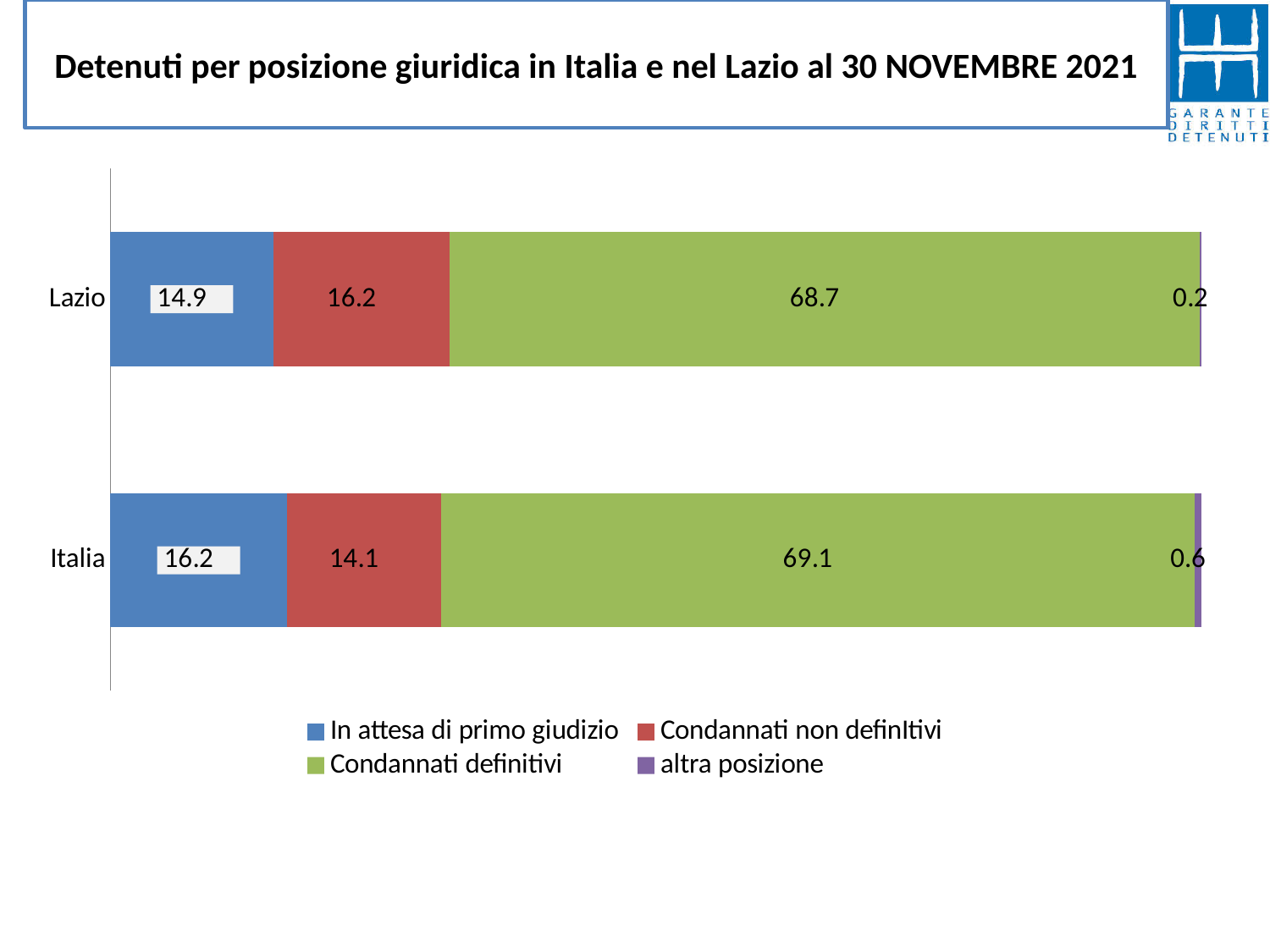
What is the total of the stacked bar for Lazio? 100.0 What is the value for "Condannati definitivi" for Lazio? 68.7 Which is larger: "Condannati non definitivi" for Lazio or for Italia? Lazio Which series has the smallest value for Lazio? altra posizione What is the value for "In attesa di primo giudizio" for Italia? 16.2 What kind of chart is shown on the slide? Stacked bar chart Which series has the largest value for Italia? Condannati definitivi What is the value for "Condannati non definitivi" for Lazio? 16.2 How many series does the legend list? 4 What is the value for "altra posizione" for Italia? 0.6 How many categories (regions) are shown on the chart? 2 What is the difference between the "Condannati definitivi" values for Italia and Lazio? 0.4